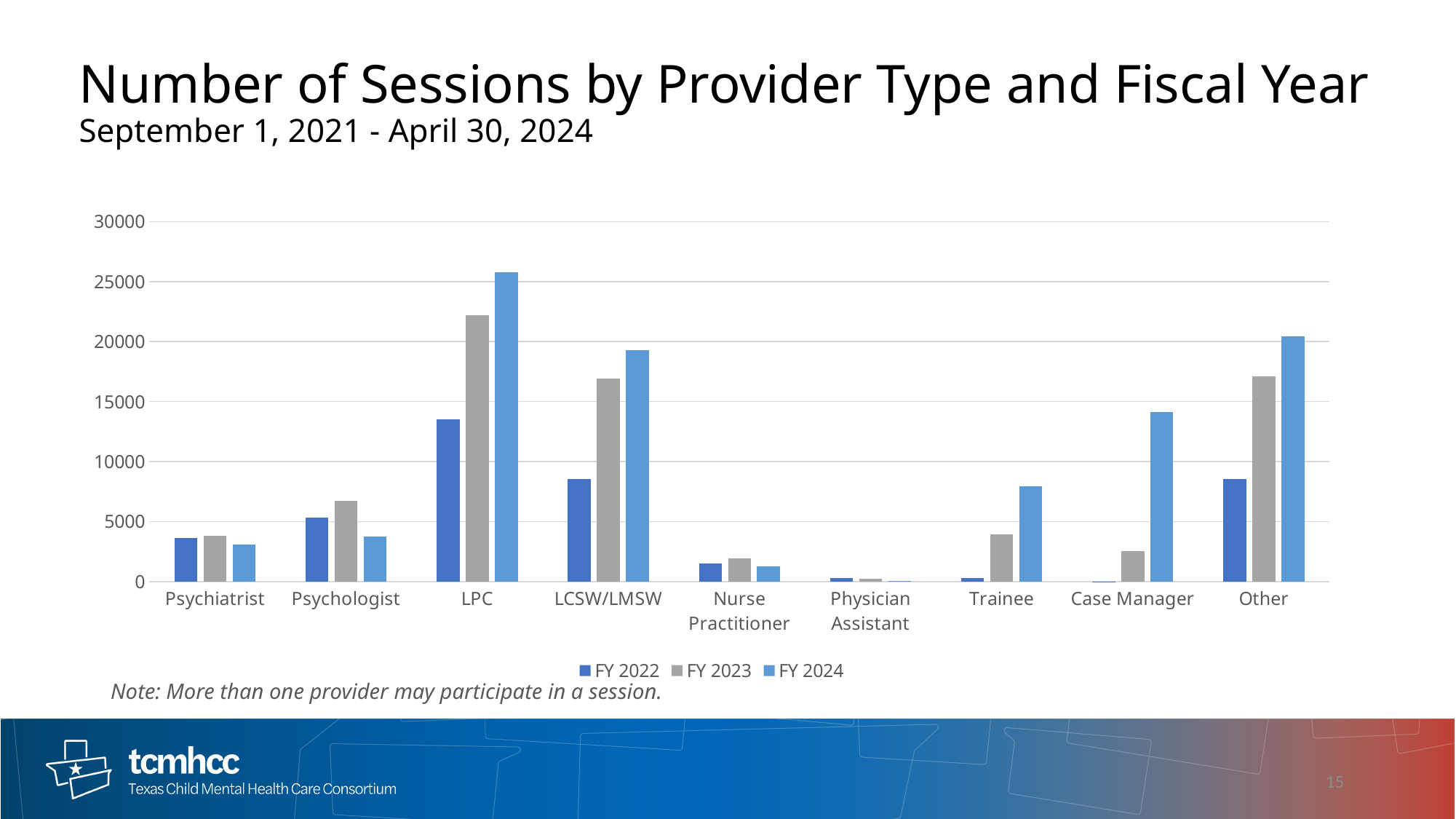
How many series does the legend list? 3 What kind of chart is shown on the slide? Bar chart Is the FY 2024 value for LPC greater or less than 25000? greater How many provider type categories are shown on the x axis? 9 Do the LPC values rise or fall from FY 2022 to FY 2024? rise Which provider type has the highest FY 2024 bar? LPC Which provider type has the lowest FY 2022 bar? Case Manager Which is larger in FY 2023: Psychologist or Psychiatrist? Psychologist Is the FY 2024 value for Psychologist greater or less than 5000? less Is the FY 2023 value for LCSW/LMSW greater or less than 15000? greater What are the three legend entries of the chart? FY 2022, FY 2023, FY 2024 Which is larger in FY 2024: Case Manager or Trainee? Case Manager